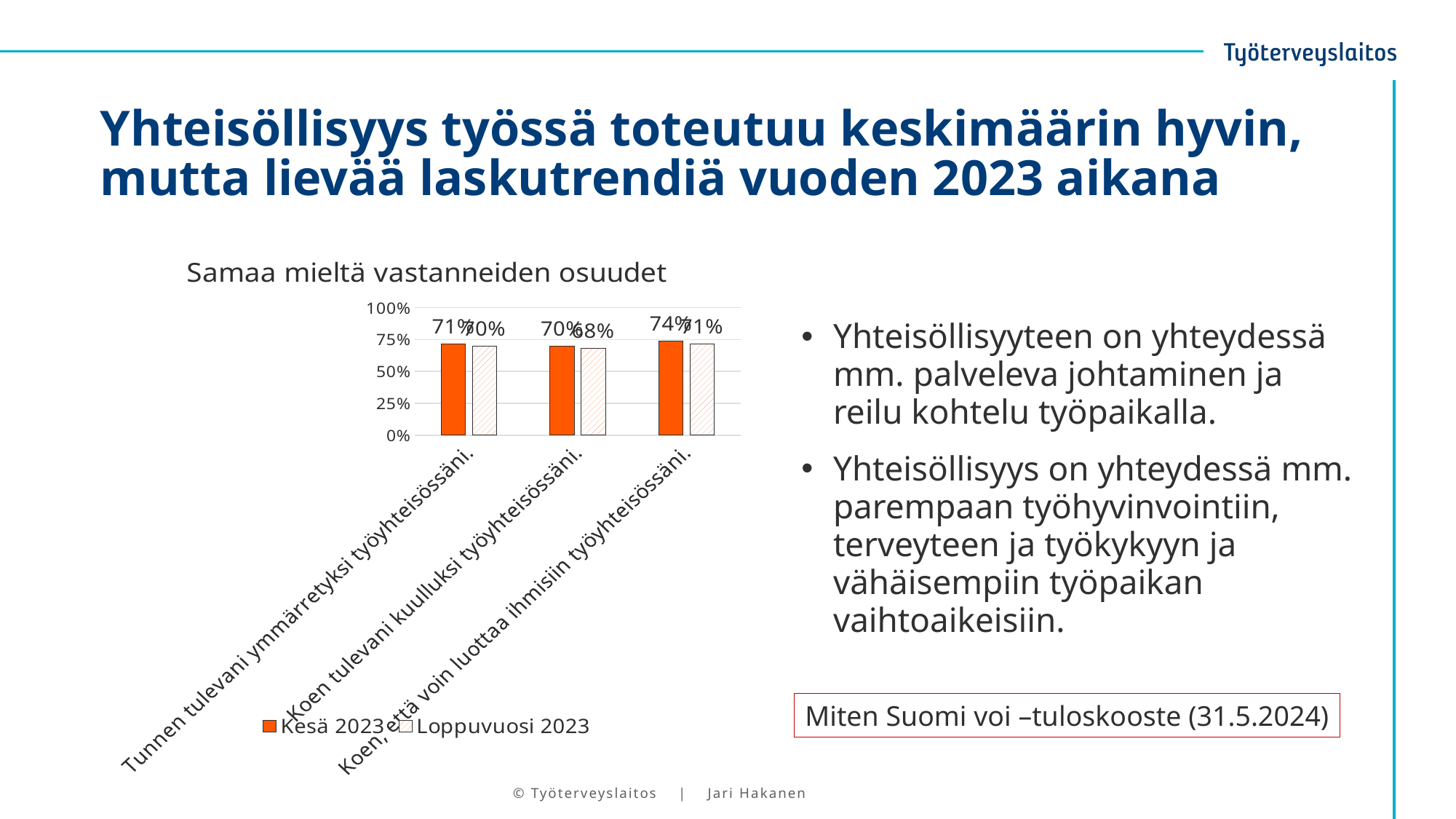
What is the title of the chart? Samaa mieltä vastanneiden osuudet What is the difference between the Kesä 2023 and Loppuvuosi 2023 values for "Koen, että voin luottaa ihmisiin työyhteisössäni."? 3 percentage points What is the value for Kesä 2023 for "Tunnen tulevani ymmärretyksi työyhteisössäni."? 71% How many categories are shown on the x axis of the chart? 3 What kind of chart is shown on the slide? Bar chart For "Koen tulevani kuulluksi työyhteisössäni.", which is larger: the Kesä 2023 value or the Loppuvuosi 2023 value? Kesä 2023 What is the value for Kesä 2023 for "Koen, että voin luottaa ihmisiin työyhteisössäni."? 74% What is the value for Loppuvuosi 2023 for "Koen tulevani kuulluksi työyhteisössäni."? 68% Which category has the lowest Loppuvuosi 2023 value? Koen tulevani kuulluksi työyhteisössäni. What is the value for Loppuvuosi 2023 for "Koen, että voin luottaa ihmisiin työyhteisössäni."? 71% Which category has the highest Kesä 2023 value? Koen, että voin luottaa ihmisiin työyhteisössäni. How many series does the chart legend list? 2